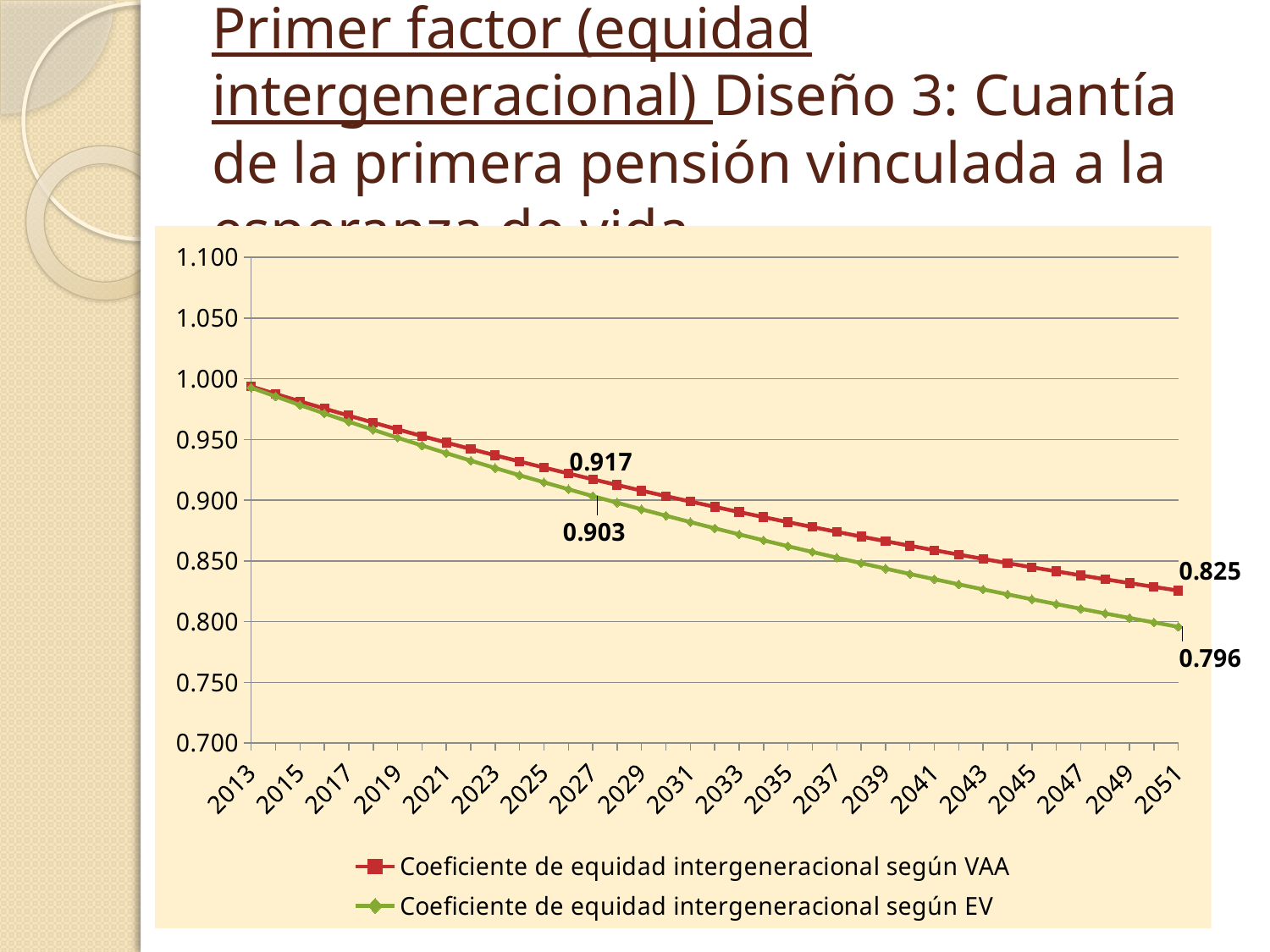
What value is labelled on the VAA series in 2027? 0.917 What value is labelled on the EV series in 2027? 0.903 Do the values of both series rise or fall from 2013 to 2051? fall What is the difference between the VAA and EV values in 2027? 0.014 What is the difference between the VAA and EV values in 2051? 0.029 What is the value of the 'Coeficiente de equidad intergeneracional según VAA' series in 2051? 0.825 Is the value of the VAA series in 2013 greater or less than 0.950? greater What kind of chart is shown on the slide? line chart Is the value of the EV series in 2045 greater or less than 0.850? less How many series does the legend list? 2 In 2051, which series has the larger value, VAA or EV? VAA What is the value of the 'Coeficiente de equidad intergeneracional según EV' series in 2051? 0.796